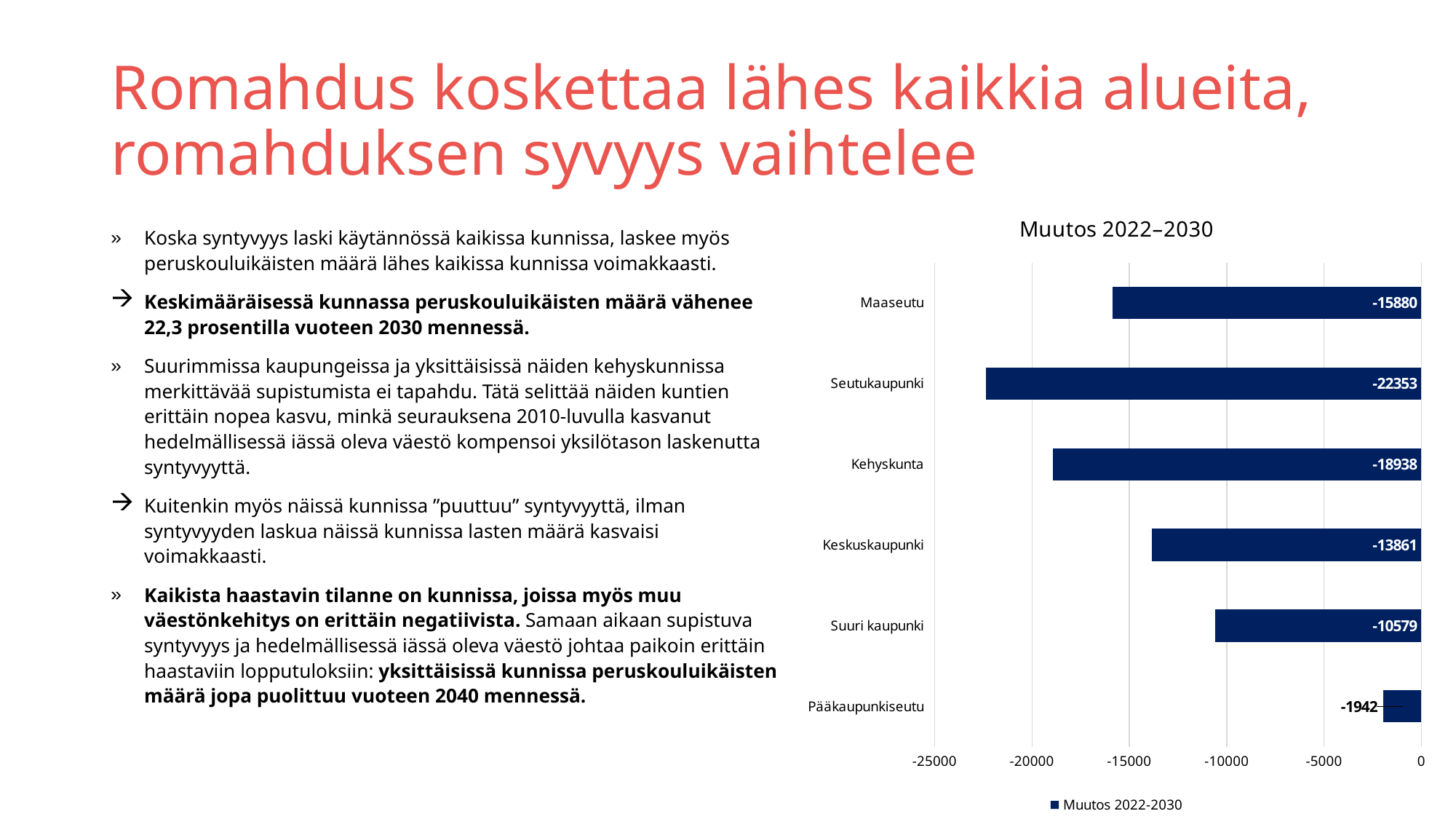
What kind of chart is shown on the slide? Bar chart What is the value for Keskuskaupunki in the chart? -13861 Which has the larger decrease, Suuri kaupunki or Kehyskunta? Kehyskunta By how much does the decrease for Kehyskunta exceed the decrease for Keskuskaupunki? 5077 How many categories are shown in the chart? 6 Which category shows the largest decrease (most negative value) in the chart? Seutukaupunki By how much does the decrease for Seutukaupunki exceed the decrease for Maaseutu? 6473 Which category shows the smallest decrease (least negative value) in the chart? Pääkaupunkiseutu What is the value for Seutukaupunki in the chart? -22353 What is the value for Pääkaupunkiseutu in the chart? -1942 Is the value for Kehyskunta greater or less than -20000? greater What is the title of the chart? Muutos 2022–2030